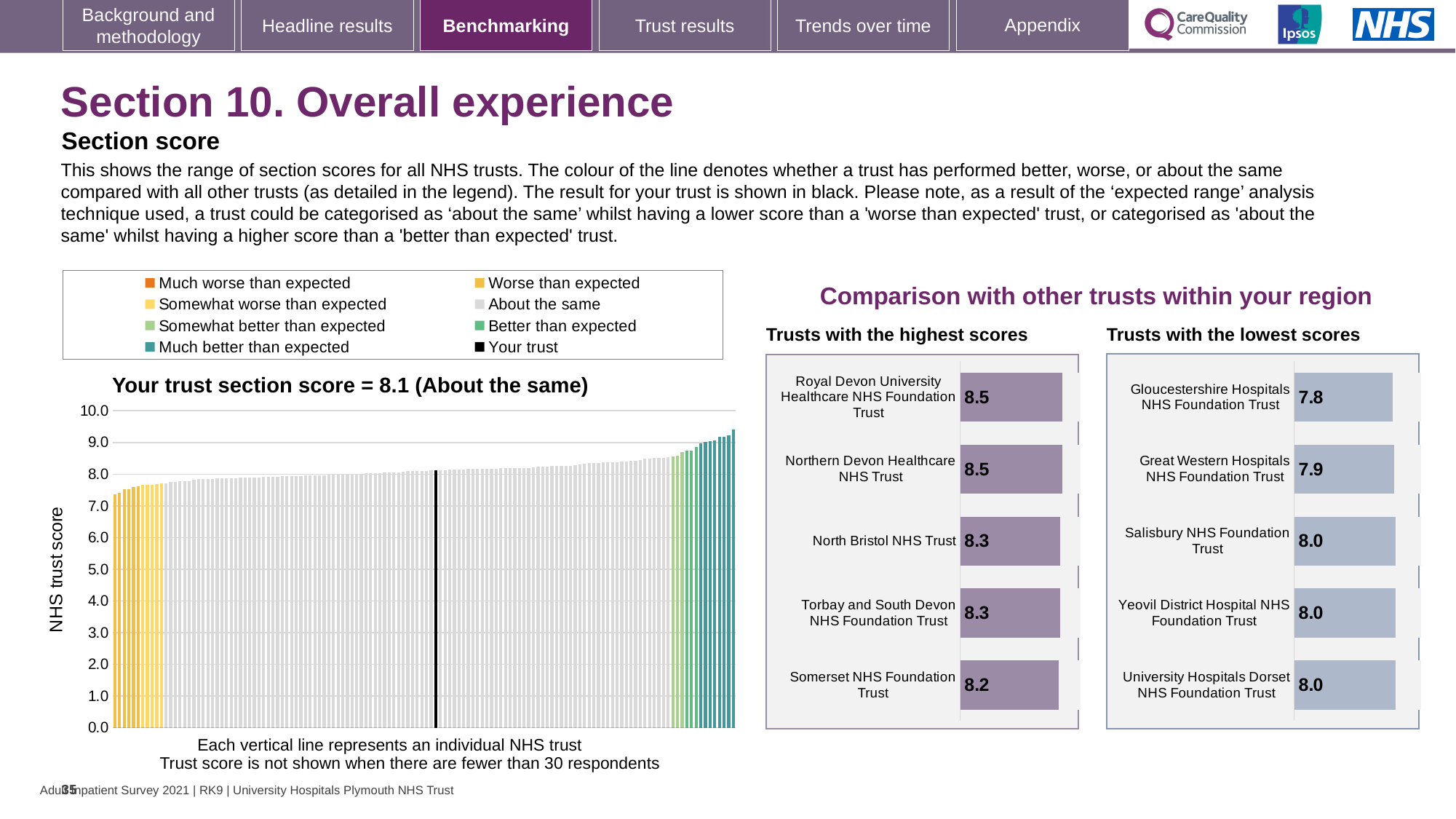
What type of chart is the 'Your trust section score' chart? Bar chart In the 'Your trust section score' chart, do the trust scores rise or fall from left to right? Rise In the 'Trusts with the highest scores' chart, which trust has the lowest score shown? Somerset NHS Foundation Trust In the 'Trusts with the highest scores' chart, what is the difference between the scores of Royal Devon University Healthcare NHS Foundation Trust and Somerset NHS Foundation Trust? 0.3 In the 'Your trust section score' chart, is the value of the leftmost bar greater or less than 8.0? less In the 'Trusts with the lowest scores' chart, which trust has the lowest score? Gloucestershire Hospitals NHS Foundation Trust In the 'Trusts with the lowest scores' chart, which has the higher score: Gloucestershire Hospitals NHS Foundation Trust or Salisbury NHS Foundation Trust? Salisbury NHS Foundation Trust In the 'Trusts with the lowest scores' chart, what is the score for Great Western Hospitals NHS Foundation Trust? 7.9 How many entries does the legend above the 'Your trust section score' chart list? 8 In the 'Trusts with the highest scores' chart, what is the score for North Bristol NHS Trust? 8.3 How many trusts are listed in the 'Trusts with the highest scores' chart? 5 In the 'Your trust section score' chart, what is the section score for your trust? 8.1